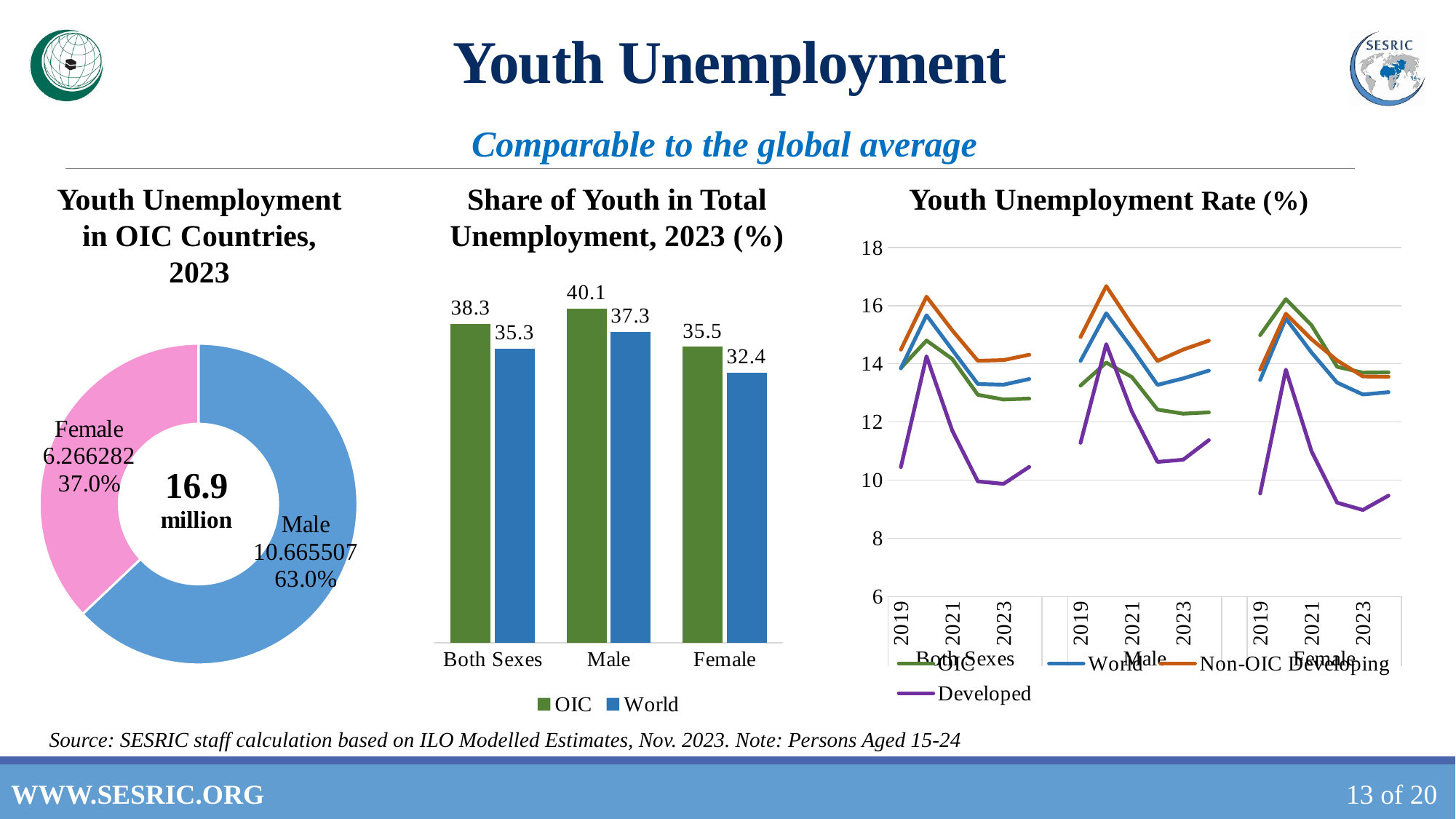
How many series does the legend of the 'Youth Unemployment Rate (%)' chart list? 4 In the 'Youth Unemployment in OIC Countries, 2023' chart, what is the value shown for Male? 10.665507 In the 'Share of Youth in Total Unemployment, 2023 (%)' chart, what is the OIC value for Male? 40.1 In the 'Share of Youth in Total Unemployment, 2023 (%)' chart, what is the World value for Female? 32.4 In the 'Youth Unemployment in OIC Countries, 2023' chart, what total is shown in the centre of the donut? 16.9 million In the 'Youth Unemployment in OIC Countries, 2023' chart, what share of youth unemployment is female? 37.0% In the 'Share of Youth in Total Unemployment, 2023 (%)' chart, which is larger for Female: OIC or World? OIC In the 'Youth Unemployment Rate (%)' chart, is the Developed value for Female in 2023 greater or less than 10? less In the 'Share of Youth in Total Unemployment, 2023 (%)' chart, what is the difference between the OIC and World values for Both Sexes? 3.0 In the 'Share of Youth in Total Unemployment, 2023 (%)' chart, which category has the highest OIC value? Male How many series does the legend of the 'Share of Youth in Total Unemployment, 2023 (%)' chart list? 2 What kind of chart is 'Youth Unemployment in OIC Countries, 2023'? Donut (pie) chart